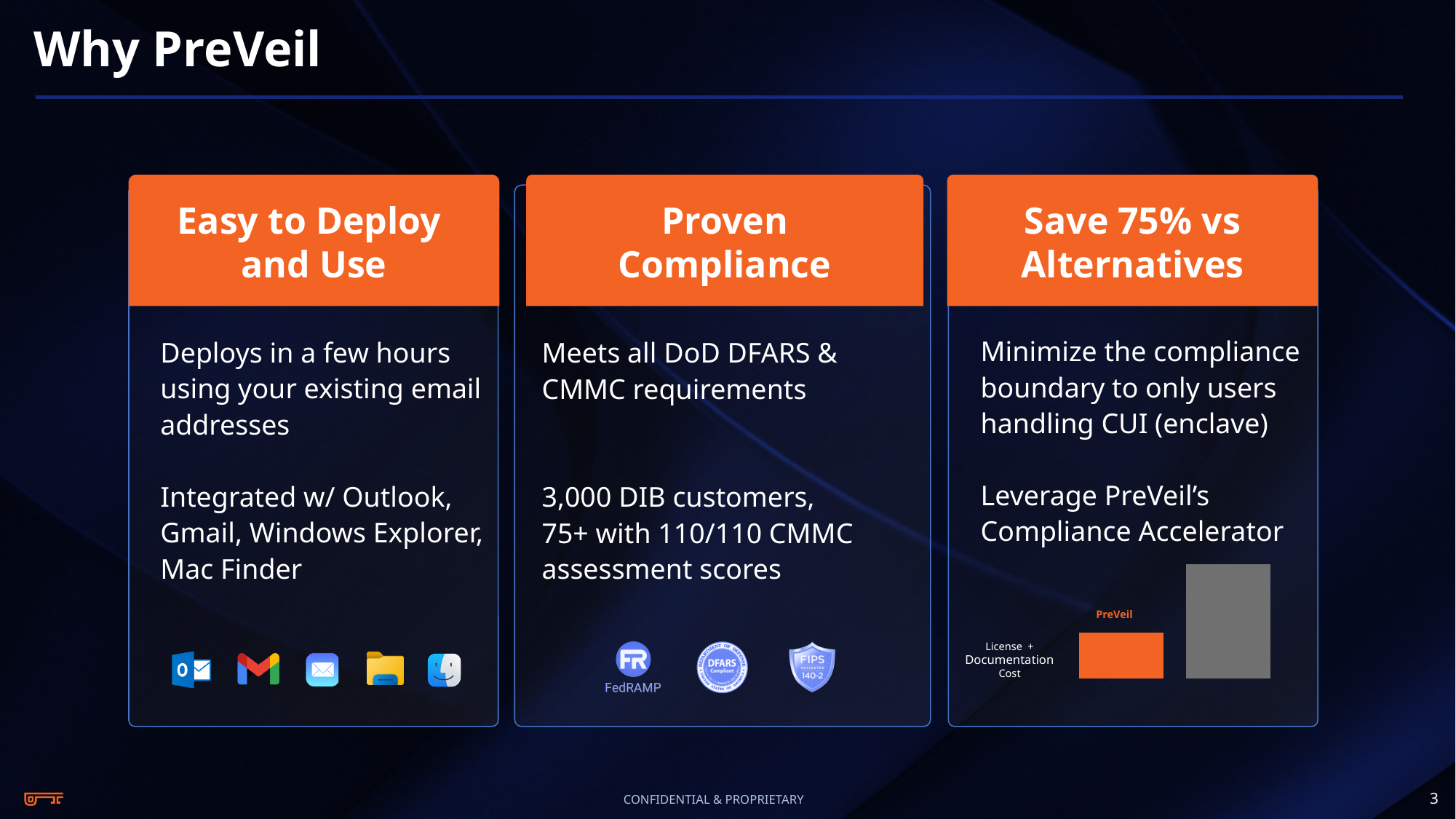
In the bar chart in the "Save 75% vs Alternatives" panel, is the PreVeil bar taller or shorter than the gray bar? shorter In the bar chart in the "Save 75% vs Alternatives" panel, how many bars are plotted? 2 In the bar chart in the "Save 75% vs Alternatives" panel, what colour is the PreVeil bar? orange What kind of chart is shown in the "Save 75% vs Alternatives" panel? bar chart In the bar chart in the "Save 75% vs Alternatives" panel, what cost does the chart compare? License + Documentation Cost In the bar chart in the "Save 75% vs Alternatives" panel, which labelled bar is the shortest? PreVeil